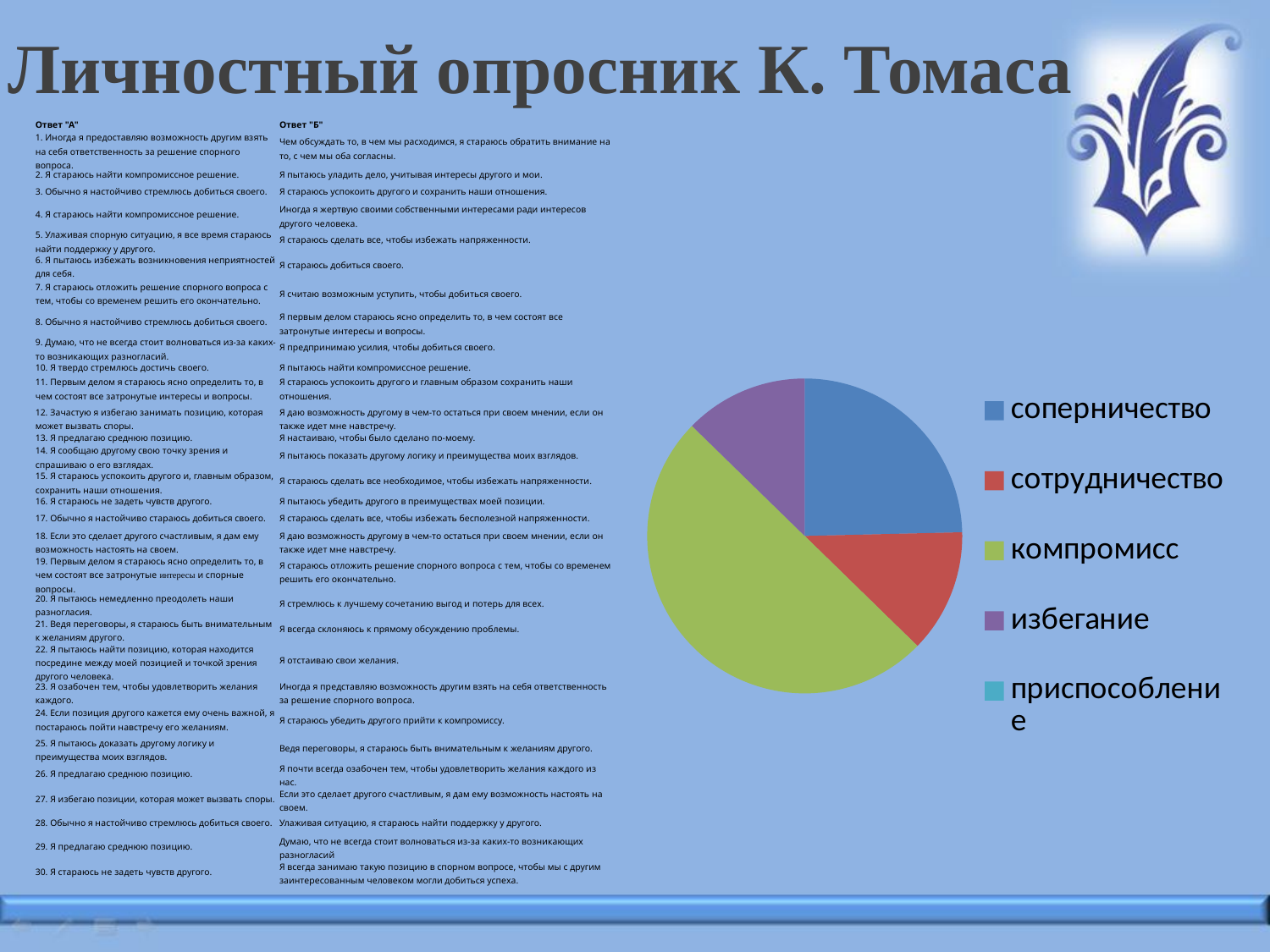
Which slice is larger in the pie chart, компромисс or избегание? компромисс What colour represents компромисс in the pie chart? green What kind of chart is shown on the slide? pie chart Which slice is larger in the pie chart, компромисс or сотрудничество? компромисс Which slice is larger in the pie chart, соперничество or избегание? соперничество Which category is shown in blue in the pie chart? соперничество How many categories does the legend of the pie chart list? 5 Which category has the largest slice in the pie chart? компромисс